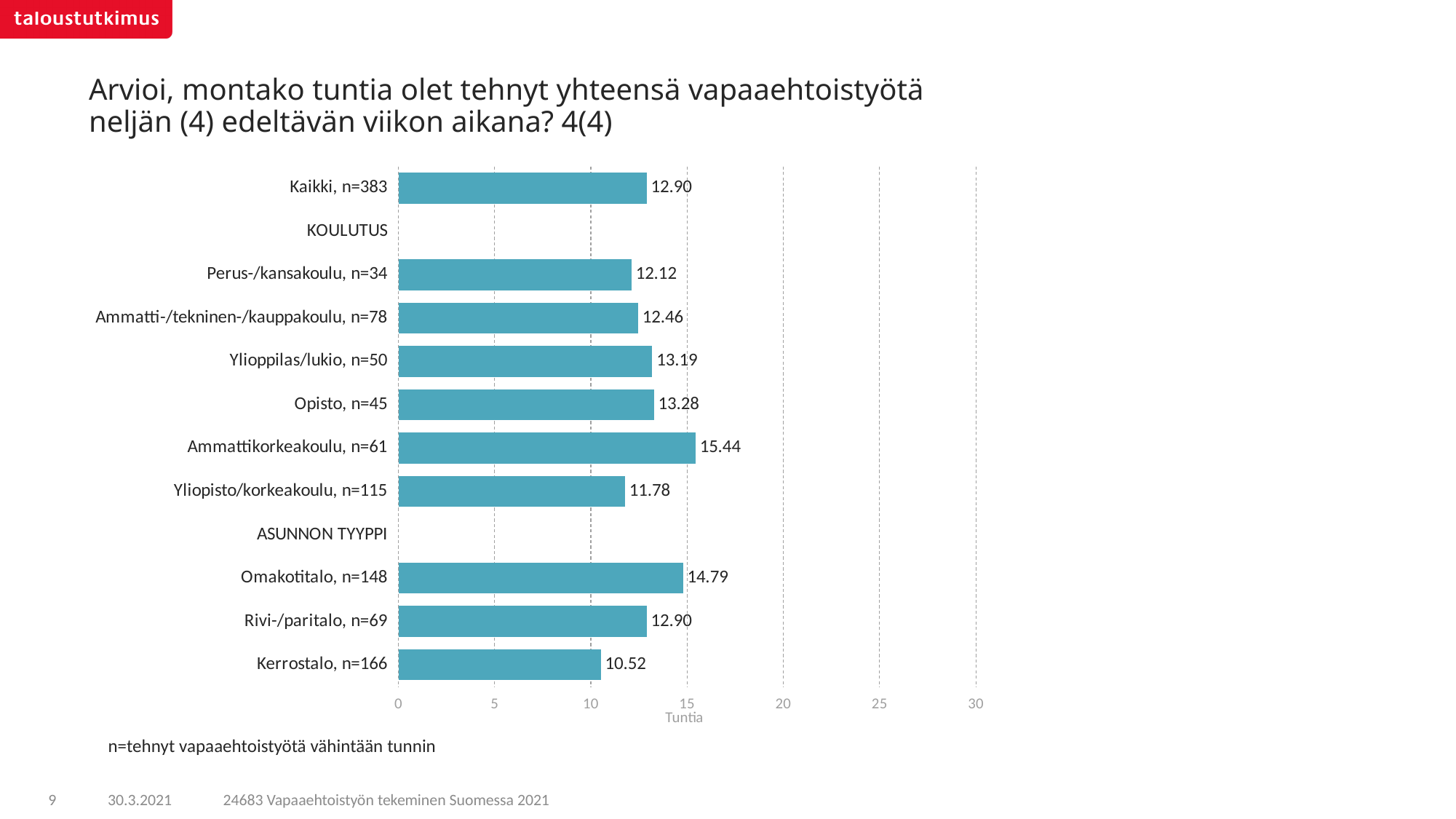
Is the value for Omakotitalo, n=148 greater or less than 10? greater Which category has the highest value? Ammattikorkeakoulu, n=61 Which category has the lowest value? Kerrostalo, n=166 What is the value for Ammattikorkeakoulu, n=61? 15.44 What kind of chart is shown on the slide? bar chart What is the value for Kaikki, n=383? 12.90 How many bars are plotted in the chart? 10 What is the label of the horizontal axis? Tuntia What is the value for Kerrostalo, n=166? 10.52 Which is larger, the value for Opisto, n=45 or the value for Perus-/kansakoulu, n=34? Opisto, n=45 What is the difference between the values for Omakotitalo, n=148 and Kerrostalo, n=166? 4.27 What is the value for Yliopisto/korkeakoulu, n=115? 11.78